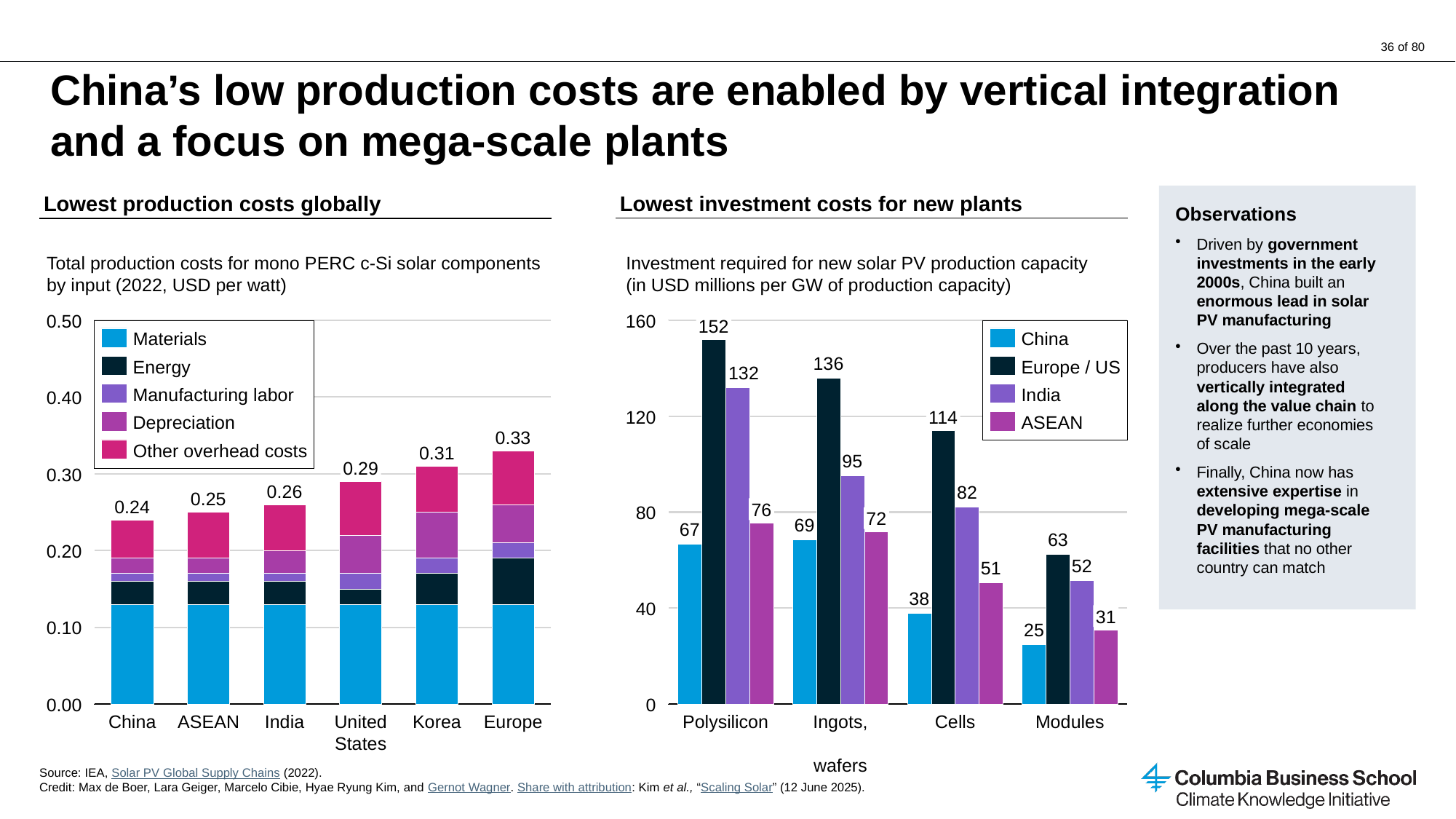
In the 'Lowest investment costs for new plants' chart, which is larger for Modules: the value for India or the value for ASEAN? India In the 'Lowest investment costs for new plants' chart, what is the difference between the India and ASEAN values for Ingots, wafers? 23 In the 'Lowest investment costs for new plants' chart, what is the investment cost for China for Modules? 25 In the 'Lowest production costs globally' chart, what is the total production cost for China? 0.24 In the 'Lowest investment costs for new plants' chart, which region has the lowest investment cost for Cells? China In the 'Lowest production costs globally' chart, how many series does the legend list? 5 In the 'Lowest investment costs for new plants' chart, what is the investment cost for Europe / US for Polysilicon? 152 In the 'Lowest production costs globally' chart, how many countries or regions are shown on the x axis? 6 In the 'Lowest production costs globally' chart, do the total production costs rise or fall from China to Europe along the x axis? rise What kind of chart is the 'Lowest investment costs for new plants' chart? bar chart In the 'Lowest production costs globally' chart, which country has the highest total production cost? Europe In the 'Lowest production costs globally' chart, what is the difference between the total for Europe and the total for China? 0.09